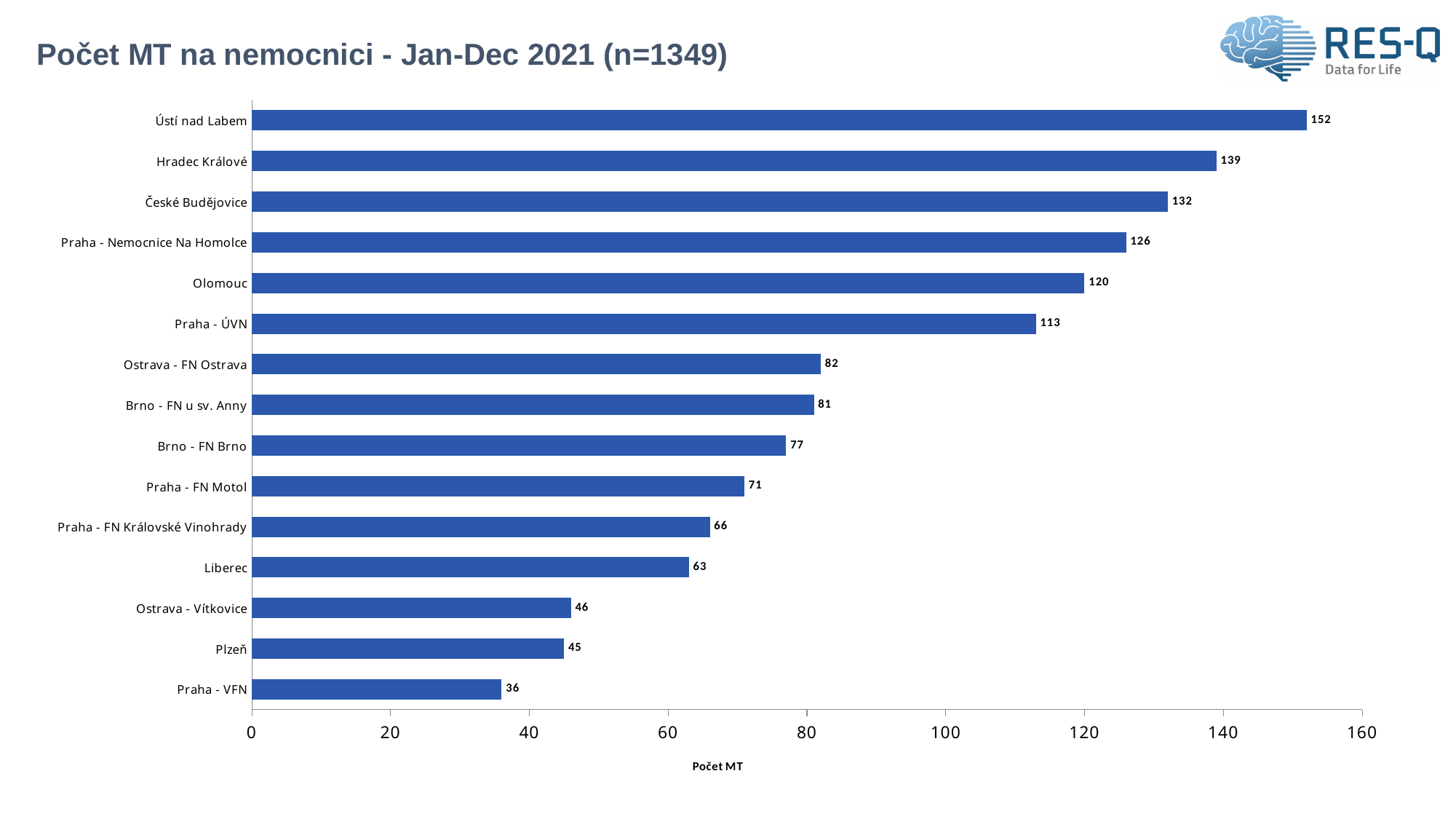
Is the value for Brno - FN Brno greater or less than 80? less What kind of chart is shown on the slide? bar chart What is the value for Liberec? 63 What is the value for Olomouc? 120 What is the difference between the values for Ústí nad Labem and Hradec Králové? 13 What is the label of the horizontal axis? Počet MT Which is larger, the value for České Budějovice or the value for Praha - Nemocnice Na Homolce? České Budějovice What is the value for Praha - FN Motol? 71 Which hospital has the lowest number of MT? Praha - VFN What is the difference between the values for Praha - ÚVN and Ostrava - FN Ostrava? 31 How many hospitals are shown in the chart? 15 Which hospital has the highest number of MT? Ústí nad Labem